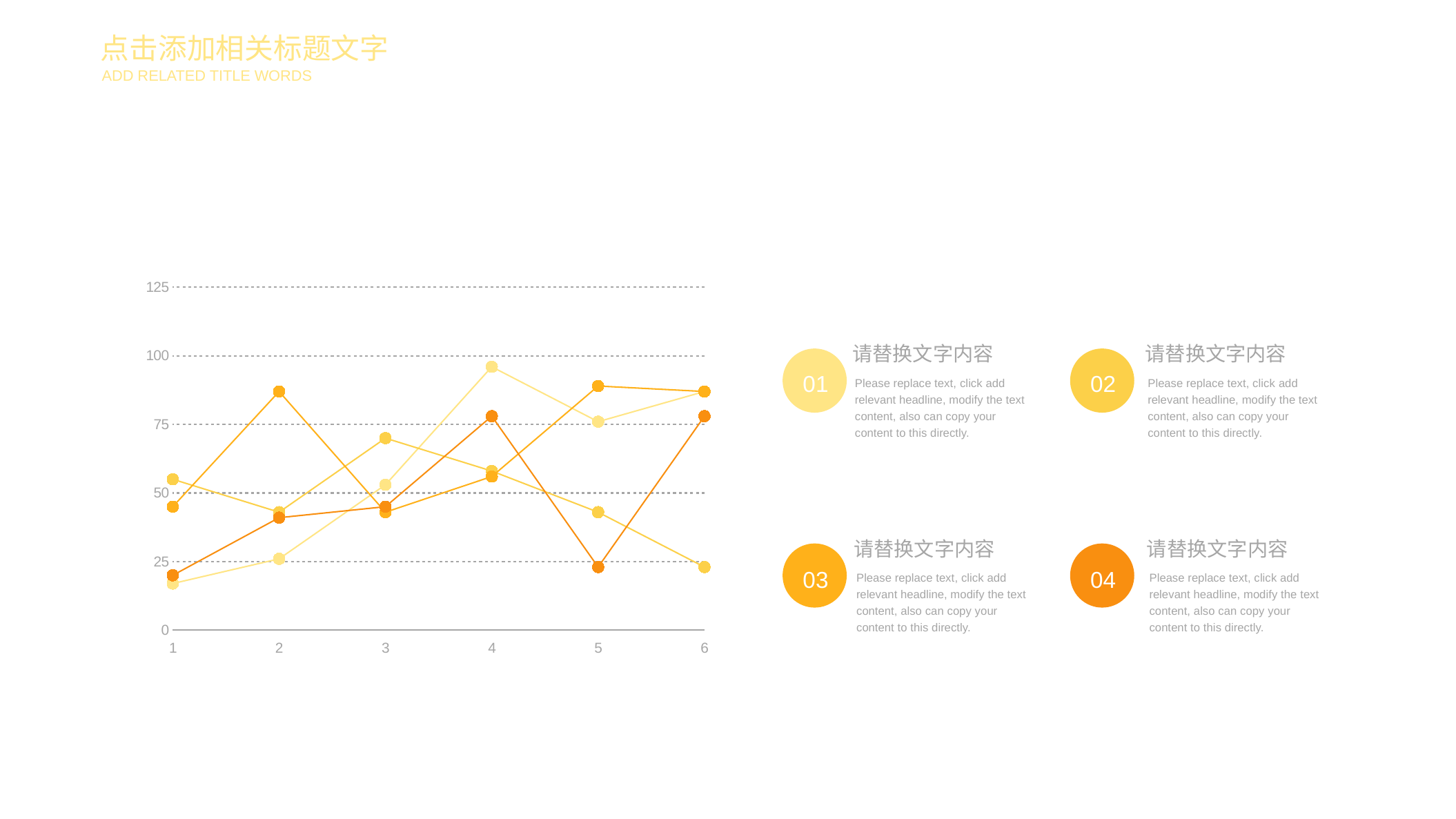
Is the lowest point on the chart greater or less than 25? less At which x-axis value does the highest point on the chart occur? 4 What is the highest value labelled on the y axis of the chart? 125 How many points are labelled along the x axis of the chart? 6 What kind of chart is shown on the slide? line chart Does the chart have a legend? No How many lines are plotted on the chart? 4 Is the highest point on the chart greater or less than 100? less